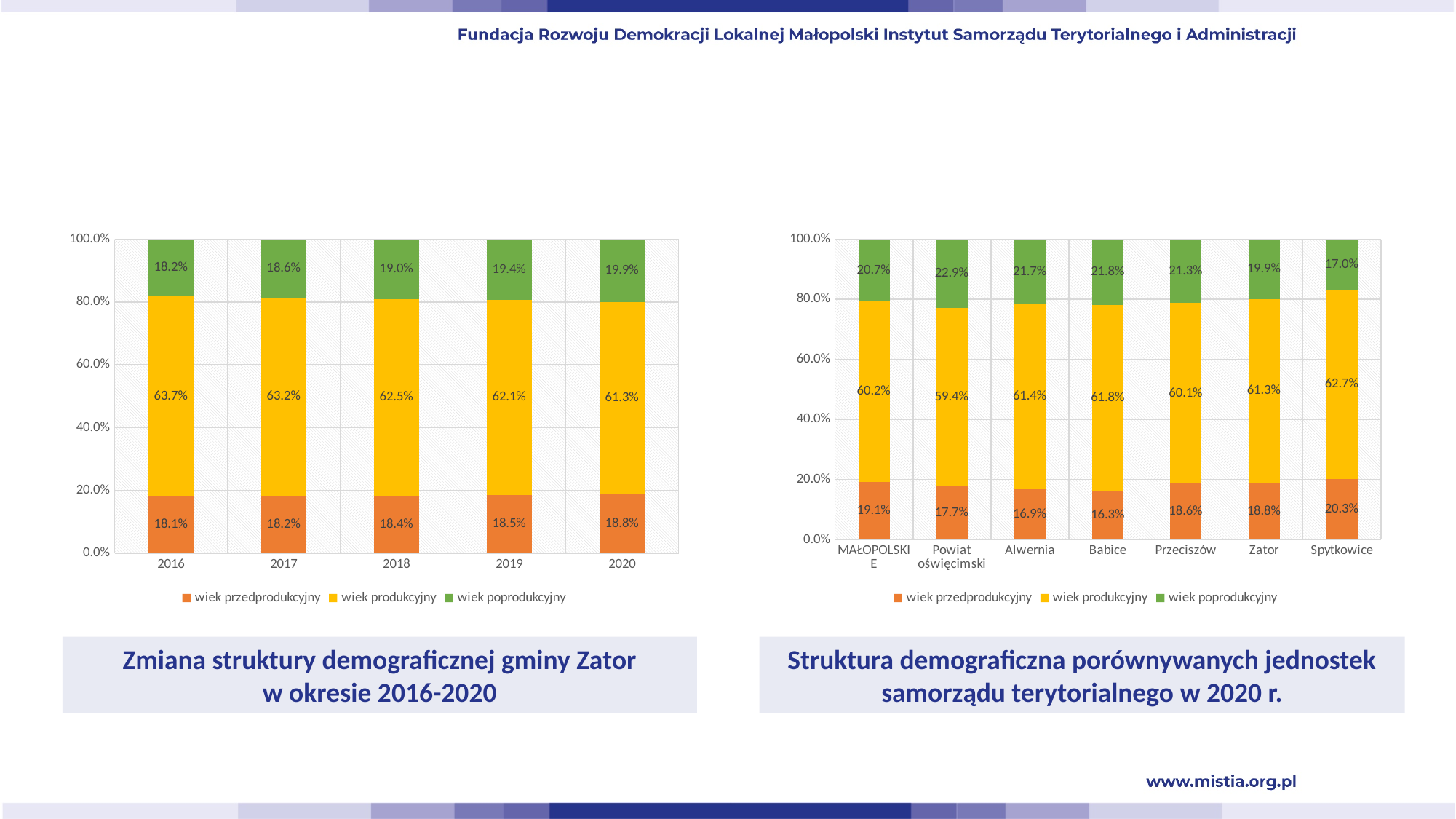
In the left chart (Zmiana struktury demograficznej gminy Zator w okresie 2016-2020), does the share of wiek produkcyjny rise or fall from 2016 to 2020? fall In the left chart (Zmiana struktury demograficznej gminy Zator w okresie 2016-2020), what is the difference between the wiek poprodukcyjny values for 2020 and 2016? 1.7% In the right chart (Struktura demograficzna porównywanych jednostek samorządu terytorialnego w 2020 r.), which unit has the highest wiek poprodukcyjny share? Powiat oświęcimski In the left chart (Zmiana struktury demograficznej gminy Zator w okresie 2016-2020), how many years are shown on the x axis? 5 In the right chart (Struktura demograficzna porównywanych jednostek samorządu terytorialnego w 2020 r.), which unit has the lowest wiek poprodukcyjny share? Spytkowice How many series does the legend of the right chart (Struktura demograficzna porównywanych jednostek samorządu terytorialnego w 2020 r.) list? 3 What kind of chart is the left chart (Zmiana struktury demograficznej gminy Zator w okresie 2016-2020)? stacked bar chart In the left chart (Zmiana struktury demograficznej gminy Zator w okresie 2016-2020), what is the value for wiek poprodukcyjny in 2020? 19.9% In the right chart (Struktura demograficzna porównywanych jednostek samorządu terytorialnego w 2020 r.), which is larger: the wiek przedprodukcyjny share for Babice or for Zator? Zator In the left chart (Zmiana struktury demograficznej gminy Zator w okresie 2016-2020), what is the value for wiek produkcyjny in 2018? 62.5% In the right chart (Struktura demograficzna porównywanych jednostek samorządu terytorialnego w 2020 r.), how many units are compared on the x axis? 7 In the right chart (Struktura demograficzna porównywanych jednostek samorządu terytorialnego w 2020 r.), what is the value for wiek przedprodukcyjny for Spytkowice? 20.3%